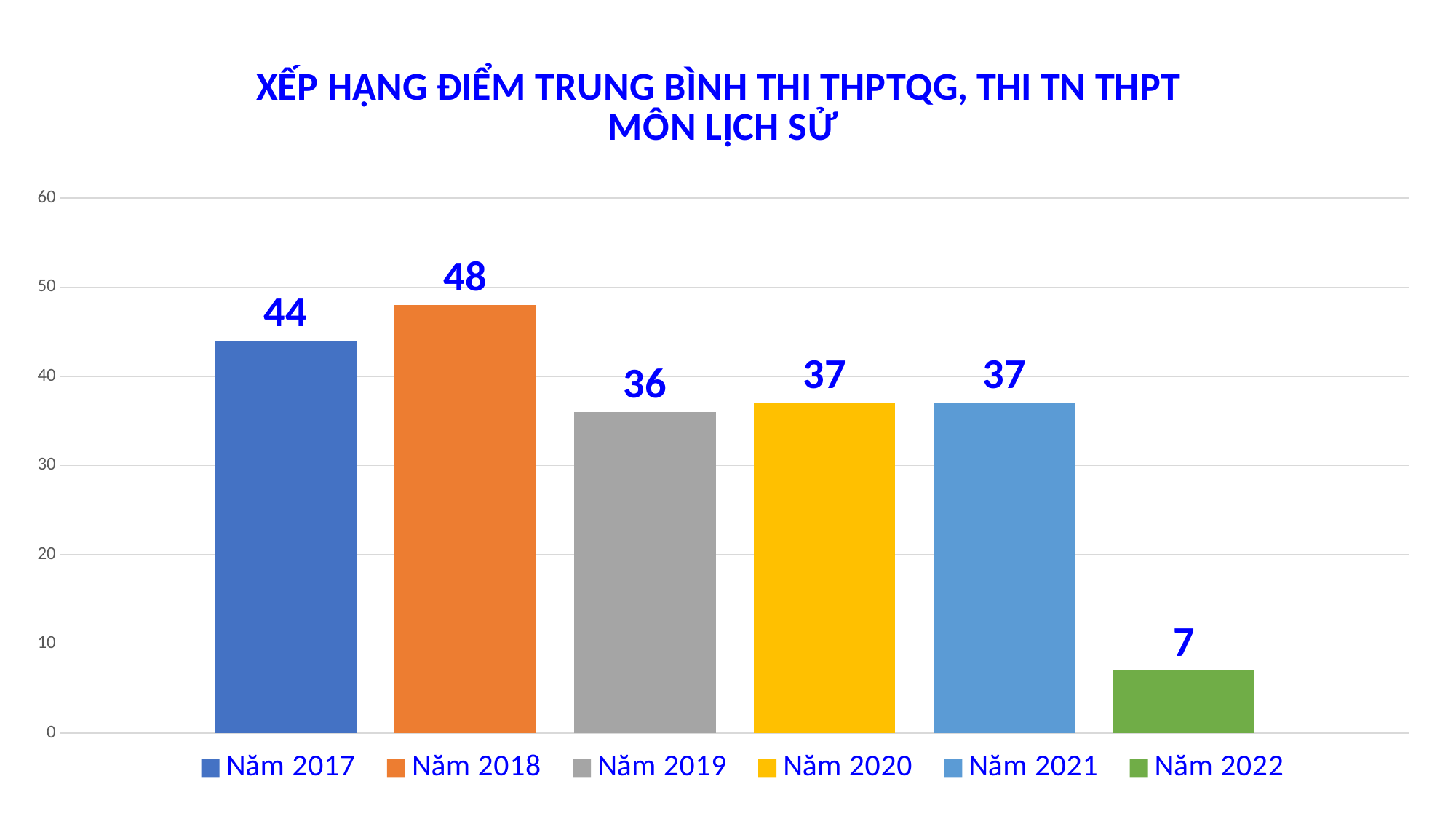
Which year has the lowest value? Năm 2022 What is the difference between the values for Năm 2018 and Năm 2017? 4 What colour is the bar for Năm 2020? yellow How many years are shown in the chart? 6 Which year has the highest value? Năm 2018 Is the value for Năm 2018 greater or less than 40? greater What is the difference between the values for Năm 2021 and Năm 2022? 30 What kind of chart is shown on the slide? bar chart What is the value for Năm 2019? 36 Which is larger, the value for Năm 2017 or the value for Năm 2020? Năm 2017 What is the value for Năm 2017? 44 What is the value for Năm 2022? 7